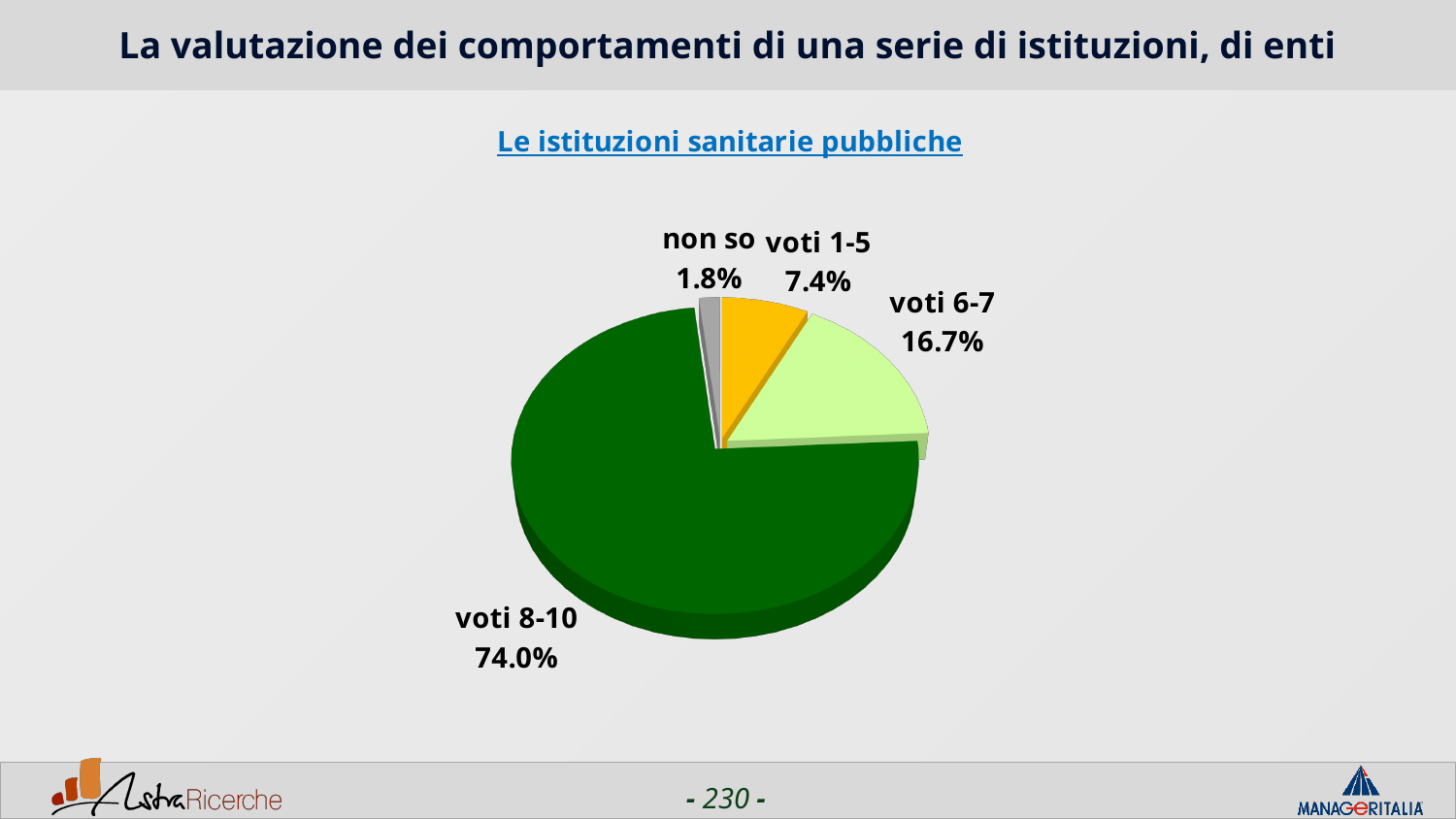
What kind of chart is shown on the slide? pie chart What is the subtitle of the chart shown on the slide? Le istituzioni sanitarie pubbliche Which is larger, the share for "voti 6-7" or the share for "voti 1-5"? voti 6-7 Which category has the smallest share of the pie? non so What percentage is shown for "non so"? 1.8% What percentage is shown for "voti 1-5"? 7.4% What is the difference in percentage points between "voti 1-5" and "non so"? 5.6 What is the difference in percentage points between "voti 8-10" and "voti 6-7"? 57.3 What percentage is shown for "voti 8-10"? 74.0% How many slices does the pie chart have? 4 Which category has the largest share of the pie? voti 8-10 What percentage is shown for "voti 6-7"? 16.7%